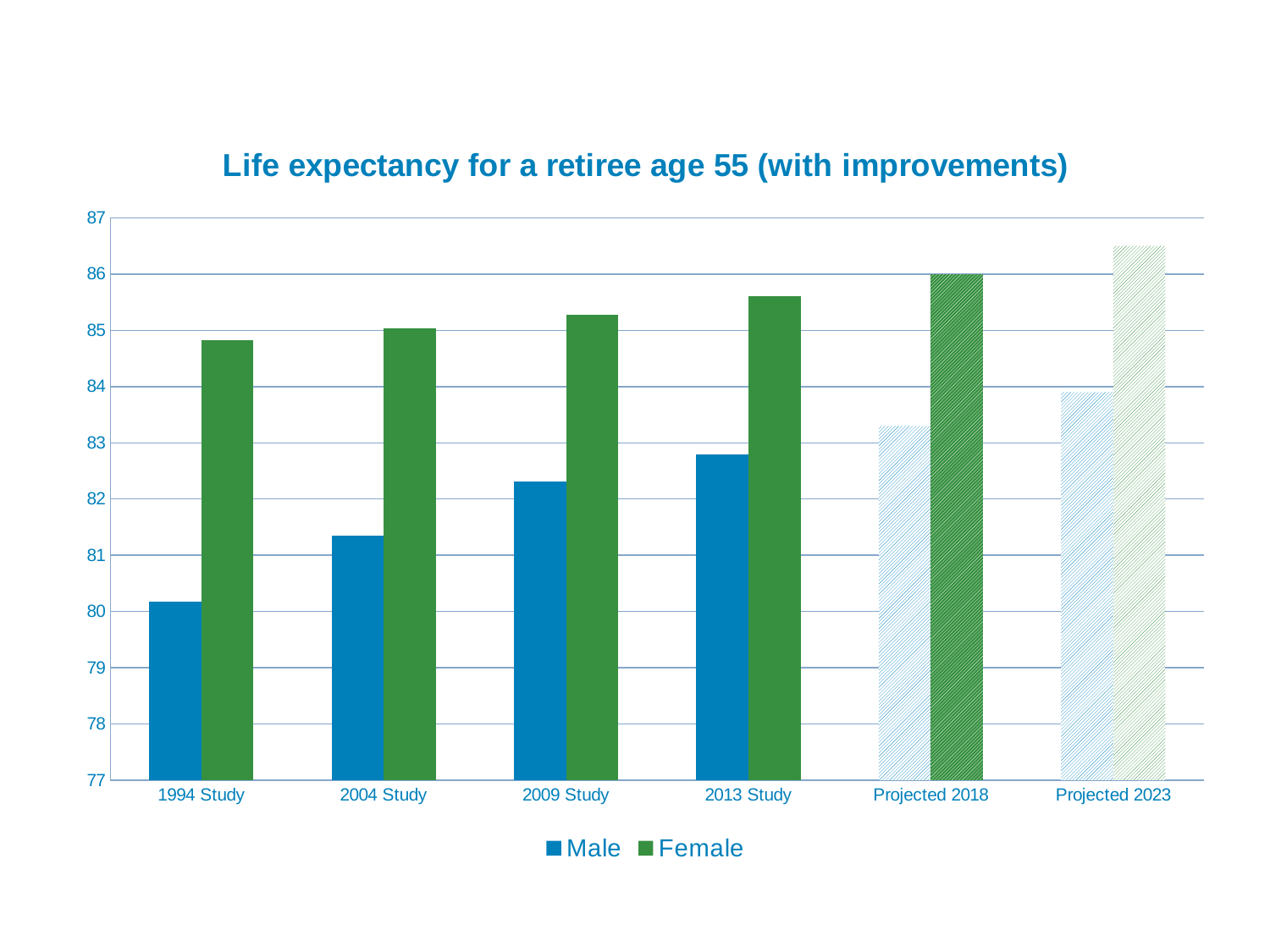
Which is larger, the Female value for the 2013 Study or the Male value for Projected 2023? Female value for the 2013 Study Which category has the lowest Male value? 1994 Study How many categories are shown on the x axis? 6 How many series does the legend list? 2 Is the Female value for the 1994 Study greater or less than 85? less Do the Male values rise or fall from the 1994 Study to Projected 2023? rise Is the Male value for Projected 2018 greater or less than 83? greater What is the title of the chart? Life expectancy for a retiree age 55 (with improvements) Is the Female value for Projected 2023 greater or less than 86? greater Which category has the highest Female value? Projected 2023 What kind of chart is shown on the slide? Bar chart